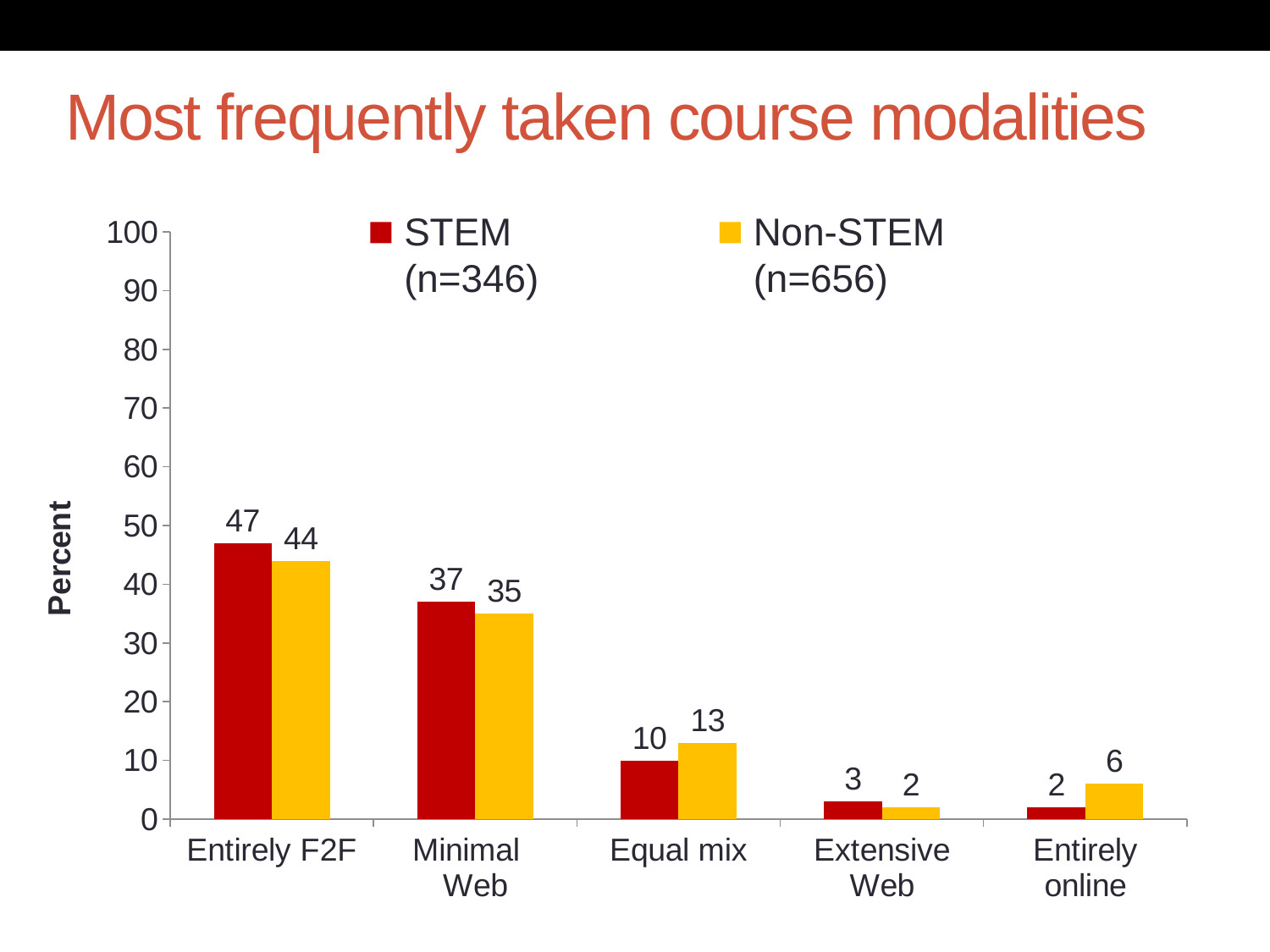
What is the title of the chart? Most frequently taken course modalities What is the STEM value for Entirely F2F? 47 What is the difference between the STEM and Non-STEM values for Minimal Web? 2 How many series does the legend list? 2 How many categories are shown on the x axis? 5 Do the STEM values rise or fall from Entirely F2F to Equal mix? Fall For Equal mix, which is larger: the STEM value or the Non-STEM value? Non-STEM What is the Non-STEM value for Entirely online? 6 What is the Non-STEM value for Equal mix? 13 What kind of chart is shown on the slide? Bar chart Which category has the lowest Non-STEM value? Extensive Web Which category has the highest STEM value? Entirely F2F